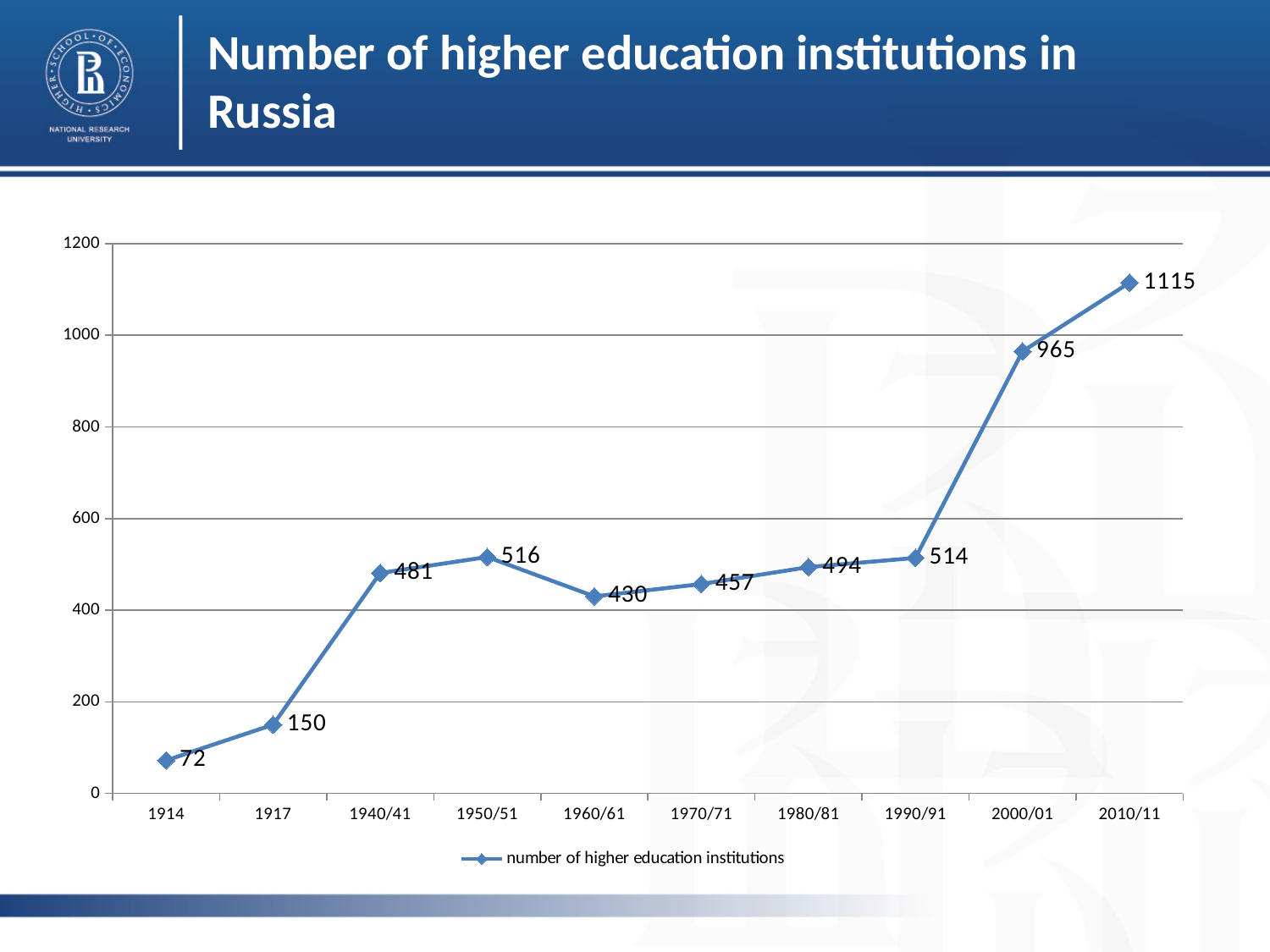
What is the number of higher education institutions in 1914? 72 Is the value for 2000/01 greater or less than 800? greater Which year has the lowest number of higher education institutions? 1914 Which year has the highest number of higher education institutions? 2010/11 What is the legend entry for the plotted series? number of higher education institutions What is the difference between the number of institutions in 2010/11 and 2000/01? 150 Which is larger, the value for 1940/41 or the value for 1990/91? 1990/91 What is the number of higher education institutions in 2000/01? 965 What kind of chart is shown on the slide? Line chart How many data points are plotted on the chart? 10 What is the difference between the number of institutions in 1950/51 and 1960/61? 86 What is the number of higher education institutions in 1960/61? 430